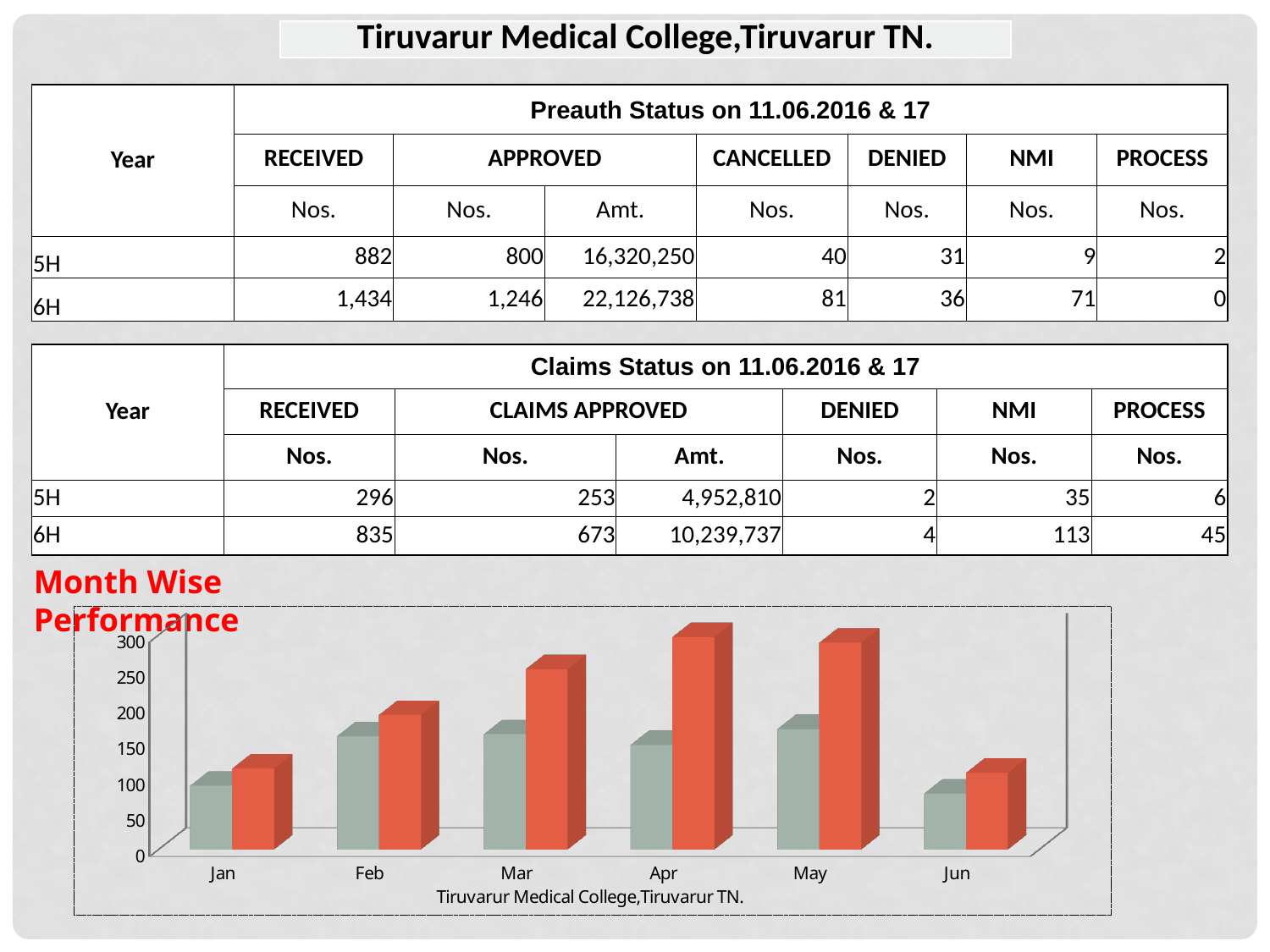
In the Month Wise Performance chart, is the grey bar for Jan greater or less than 150? less In the Month Wise Performance chart, is the red bar for Mar greater or less than 200? greater In the Month Wise Performance chart, is the red bar for Apr greater or less than 250? greater In the Month Wise Performance chart, which is larger for Mar: the grey bar or the red bar? the red bar What kind of chart is shown under the heading 'Month Wise Performance'? bar chart In the Month Wise Performance chart, do the red bars rise or fall from Jan to Apr? rise How many months are shown on the x axis of the Month Wise Performance chart? 6 How many data series (bars per month) are plotted in the Month Wise Performance chart? 2 What text appears as the axis title below the months in the Month Wise Performance chart? Tiruvarur Medical College,Tiruvarur TN. In the Month Wise Performance chart, which is larger: the red bar for Apr or the red bar for Jan? Apr